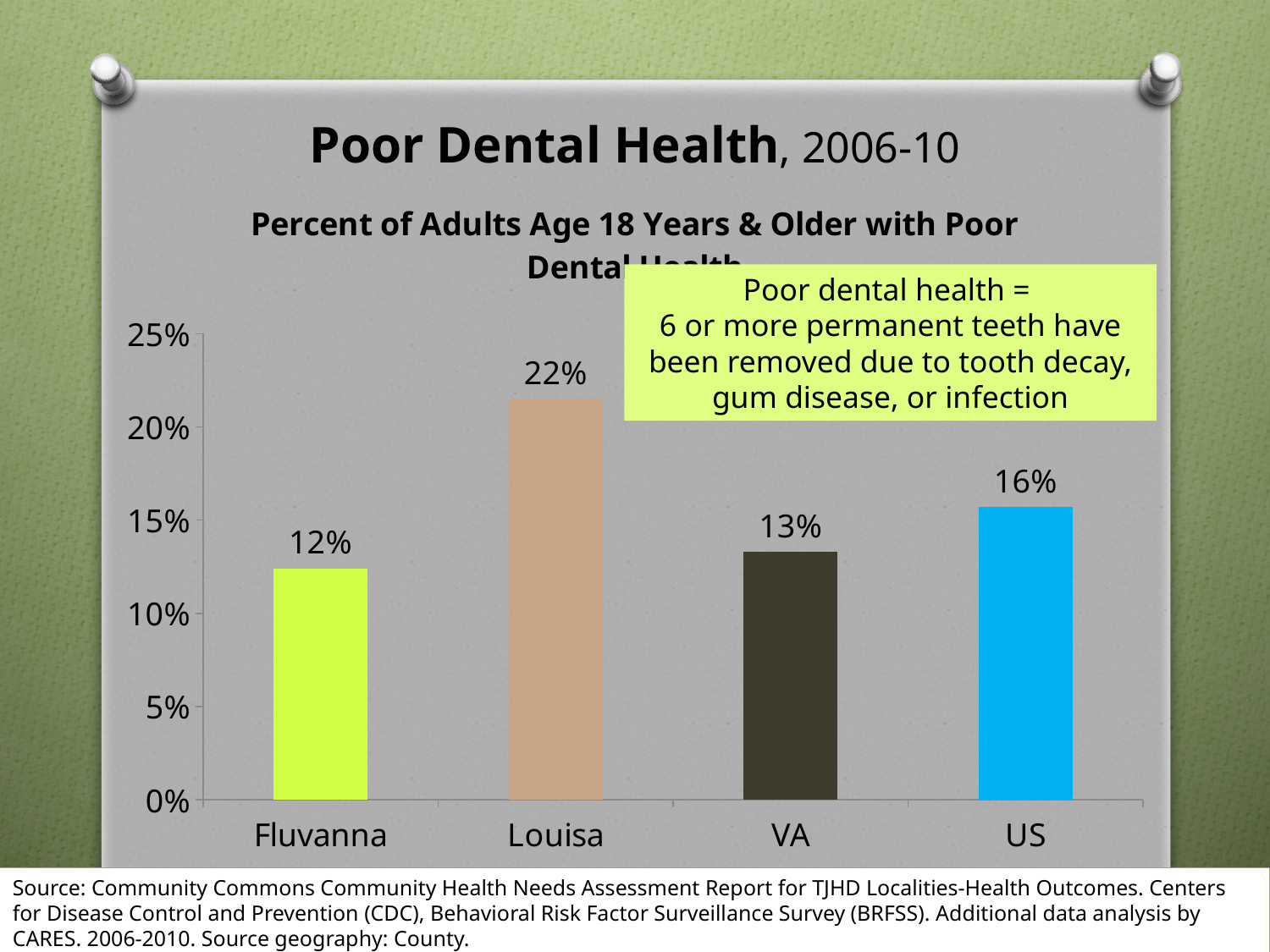
How many categories are shown on the x axis? 4 What is the value for Fluvanna? 12% What is the value for VA? 13% What is the difference between the values for US and VA? 3% What is the value for Louisa? 22% What is the value for US? 16% Which is larger, the value for Louisa or the value for US? Louisa Which category has the lowest value? Fluvanna What kind of chart is shown on the slide? bar chart Is the value for Louisa greater or less than 20%? greater Which category has the highest value? Louisa What is the difference between the values for Louisa and Fluvanna? 10%